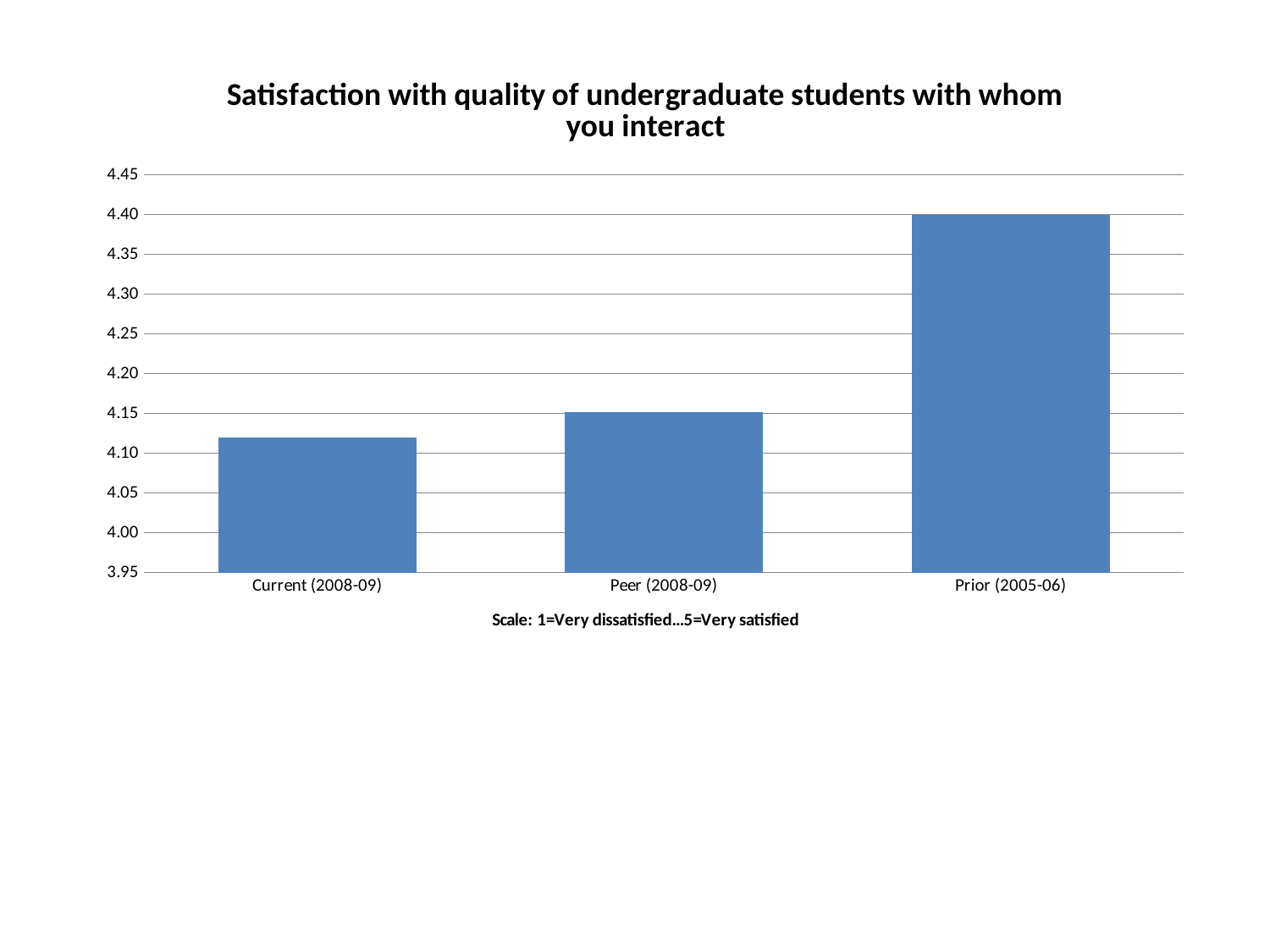
What kind of chart is shown on the slide? bar chart Which category has the highest satisfaction value? Prior (2005-06) Which category has the lowest satisfaction value? Current (2008-09) How many categories are plotted on the x axis? 3 Is the value for Current (2008-09) greater or less than 4.10? greater Is the value for Current (2008-09) greater or less than 4.15? less What scale is described in the note below the x axis? 1=Very dissatisfied...5=Very satisfied Which is larger, the value for Peer (2008-09) or the value for Current (2008-09)? Peer (2008-09) Do the values rise or fall from left to right along the x axis? rise What is the value for Prior (2005-06)? 4.40